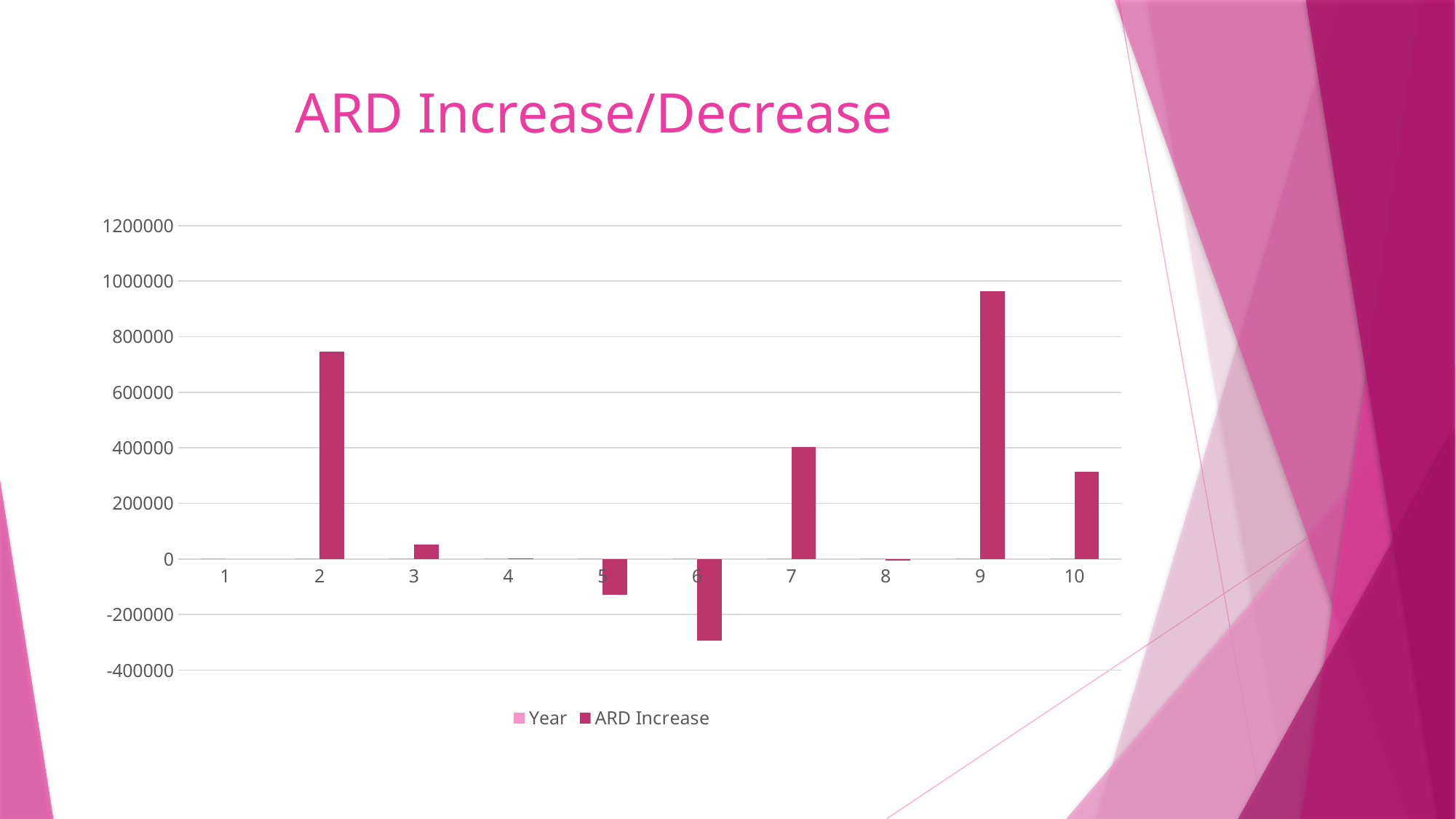
Is the ARD Increase value for category 2 greater or less than 800000? less Is the ARD Increase value for category 10 greater or less than 200000? greater How many categories are shown on the x axis? 10 What type of chart is shown on the slide? bar chart Which category has the lowest ARD Increase value? 6 Is the ARD Increase value for category 6 greater or less than -200000? less Which has the larger ARD Increase value, category 2 or category 9? 9 What is the title of the chart? ARD Increase/Decrease Which category has the highest ARD Increase value? 9 How many series does the legend list? 2 What are the two series named in the legend? Year and ARD Increase